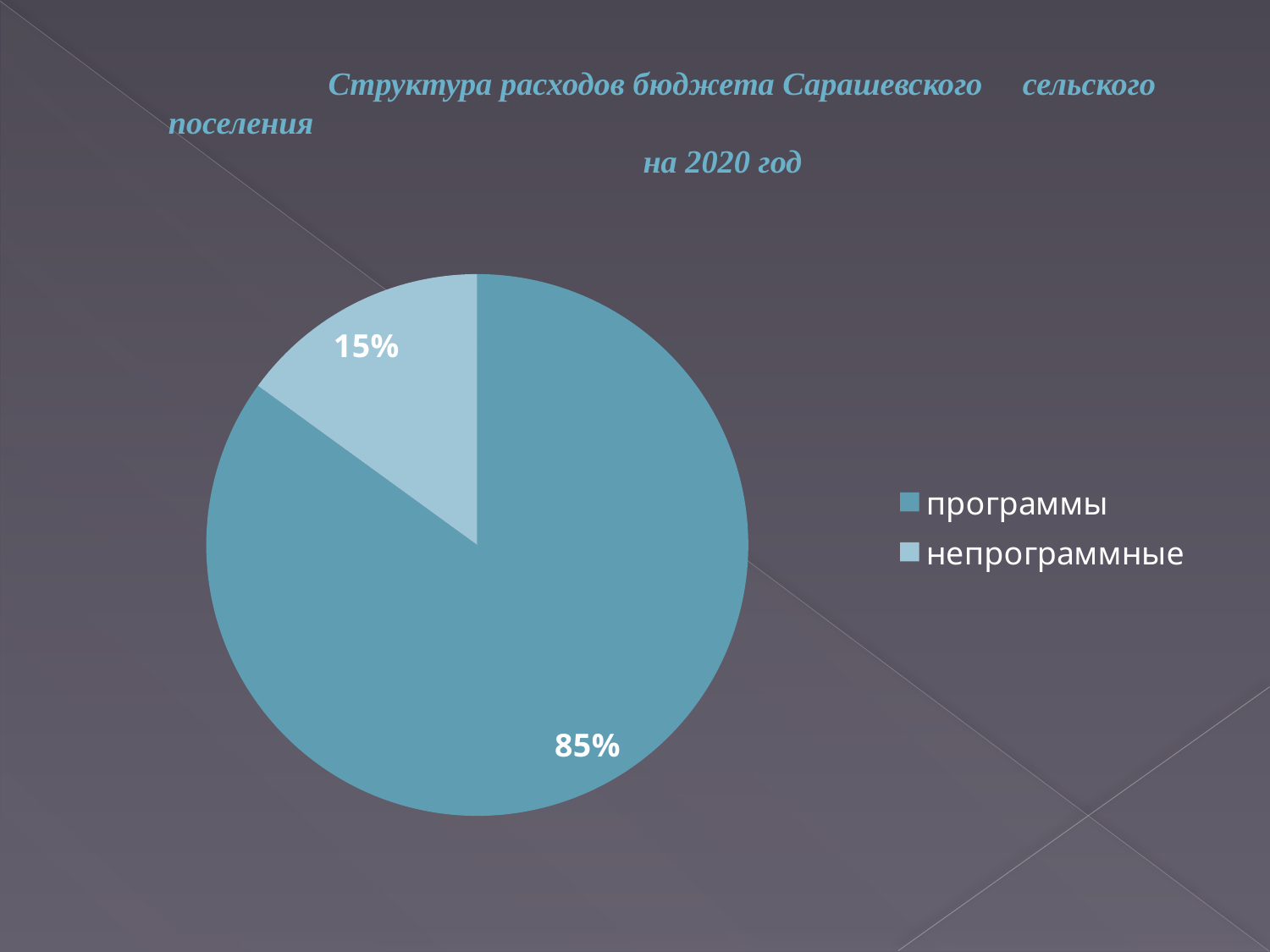
Which year does the chart title refer to? 2020 Which is larger, the "программы" slice or the "непрограммные" slice? программы What share of the pie does the "непрограммные" slice represent? 15% Which category has the largest slice of the pie? программы Which category has the smallest slice of the pie? непрограммные What kind of chart is shown on the slide? pie chart What share of the pie does the "программы" slice represent? 85% How many slices does the pie chart have? 2 Which legend entry is shown in the lighter blue colour? непрограммные How many entries does the legend list? 2 What is the difference in percentage points between the "программы" and "непрограммные" slices? 70